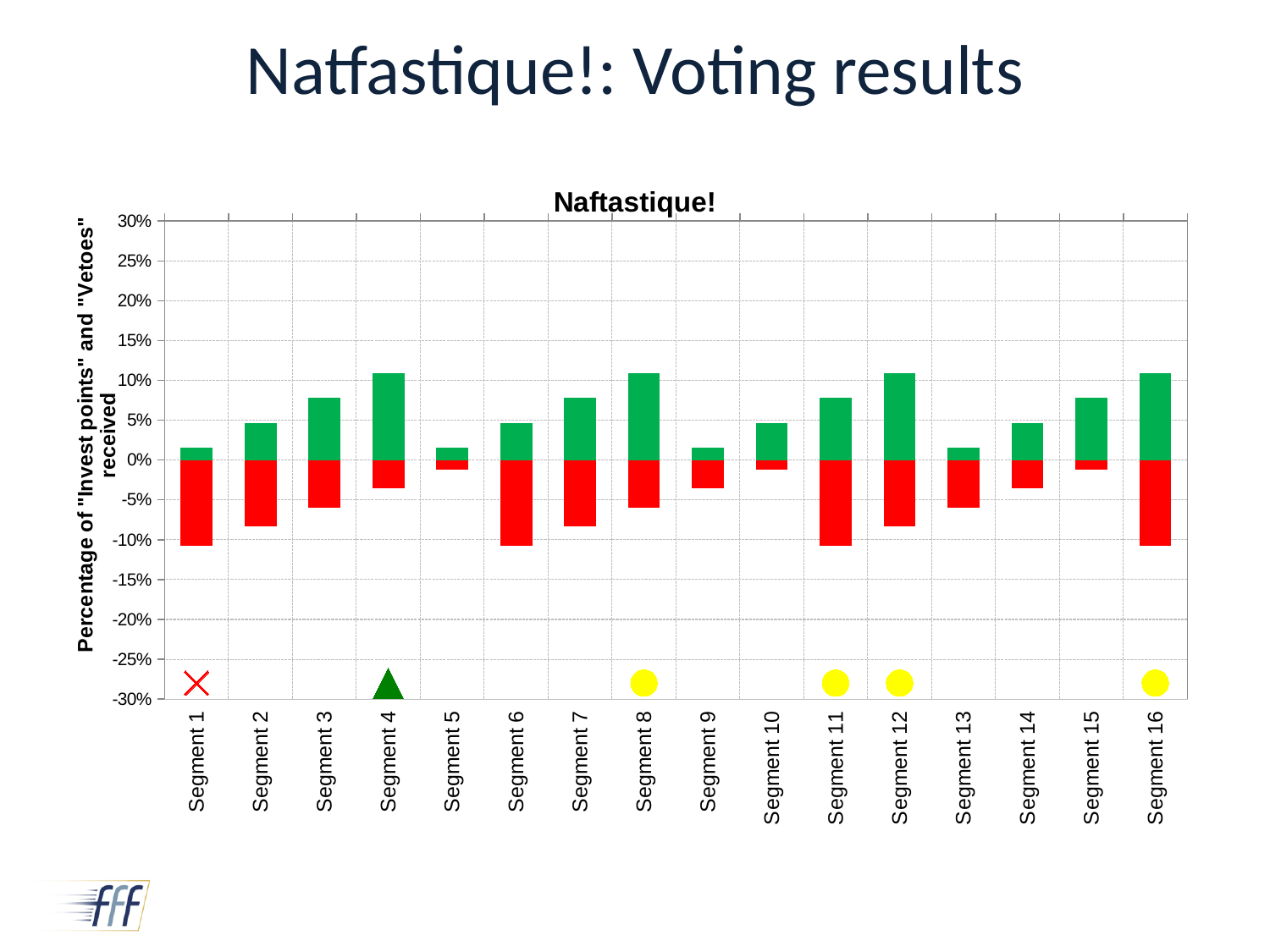
Which has the larger green (positive) value, Segment 8 or Segment 9? Segment 8 Is the green (positive) value for Segment 3 greater or less than 5%? greater Is the green (positive) value for Segment 4 greater or less than 10%? greater What is the title printed above the chart? Naftastique! Is the red (negative) value for Segment 5 greater or less than -5%? greater What is the label on the vertical axis of the chart? Percentage of "Invest points" and "Vetoes" received Which has the larger green (positive) value, Segment 4 or Segment 1? Segment 4 What kind of chart is shown on the slide? bar chart How many segments are shown on the x axis of the chart? 16